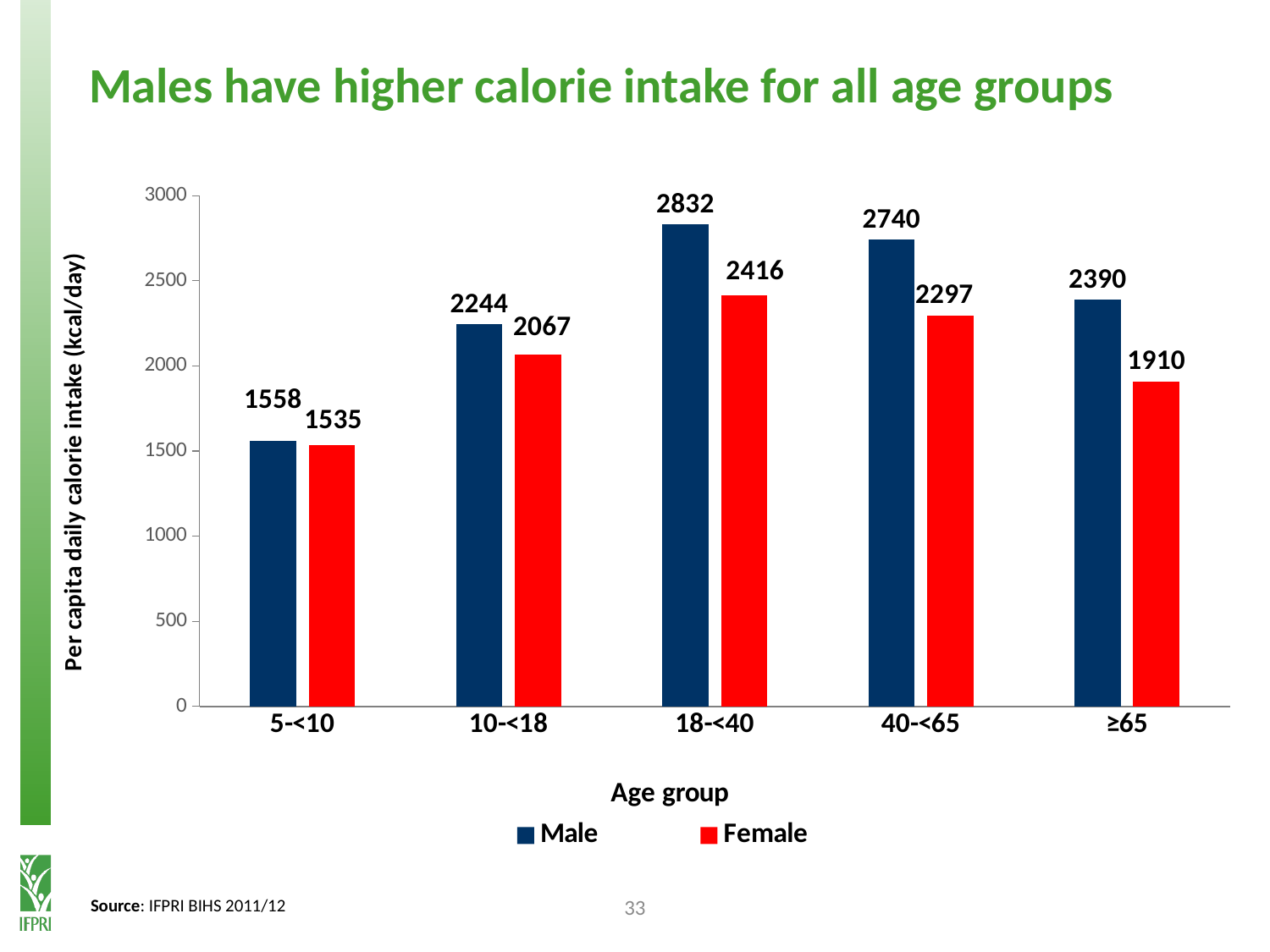
What is the difference between male calorie intake in the 18-<40 and ≥65 age groups? 442 How many series does the legend list? 2 What kind of chart is shown on the slide? Bar chart Which age group has the highest male calorie intake? 18-<40 How many age groups are shown on the x axis? 5 What is the per capita daily calorie intake for males in the 18-<40 age group? 2832 What is the difference between male and female calorie intake in the 40-<65 age group? 443 Which age group has the lowest female calorie intake? 5-<10 Which is larger: the female value for 18-<40 or the male value for ≥65? Female value for 18-<40 What is the per capita daily calorie intake for females in the ≥65 age group? 1910 What is the label of the y axis? Per capita daily calorie intake (kcal/day) What is the value for females in the 10-<18 age group? 2067